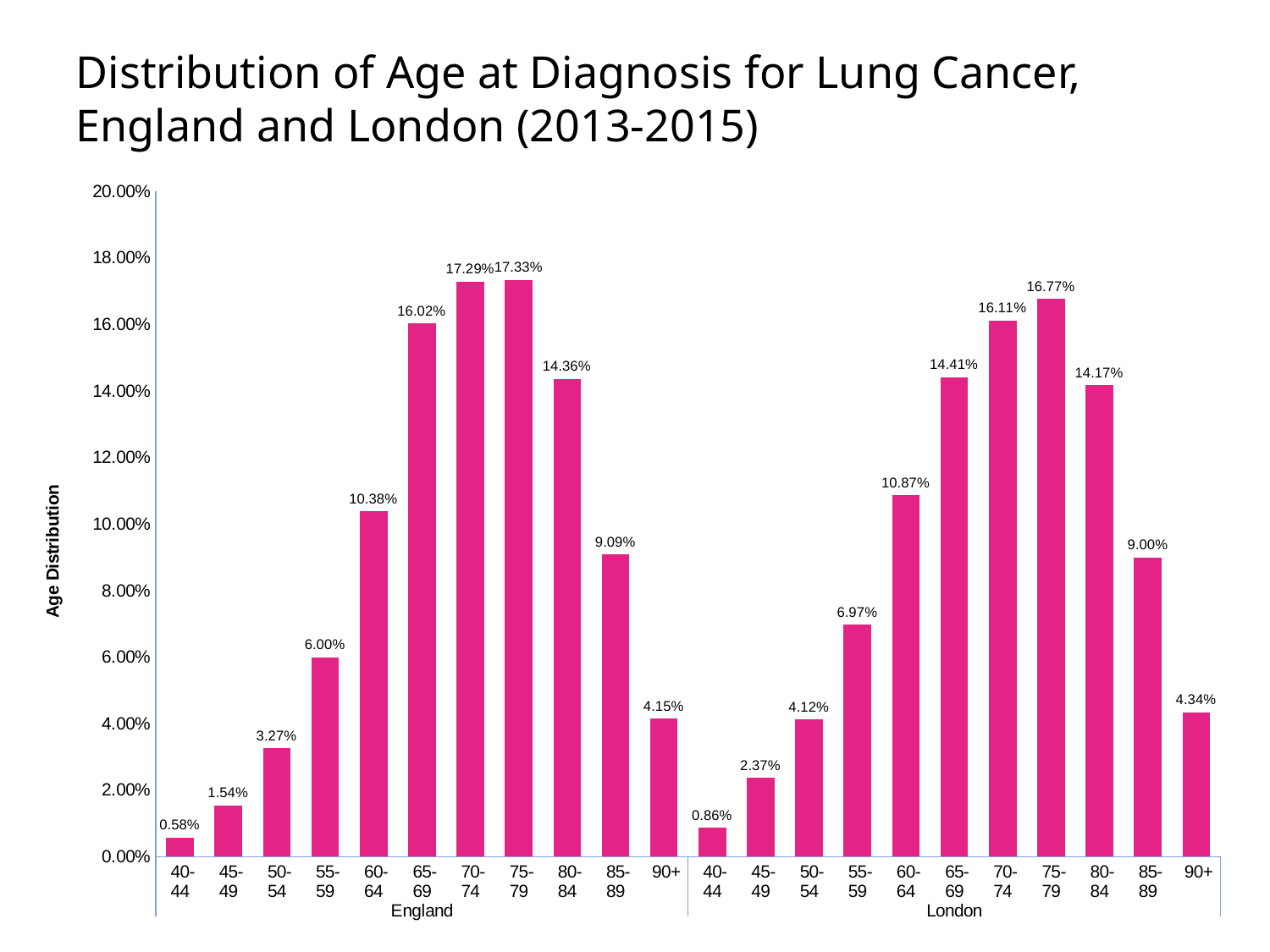
What is the difference between the England and London values for the 65-69 age band? 1.61% What is the value for the 75-79 age band in London? 16.77% What is the value for the 90+ age band in England? 4.15% What is the value for the 60-64 age band in England? 10.38% What kind of chart is shown on the slide? Bar chart What is the difference between the London and England values for the 60-64 age band? 0.49% Which age band has the highest value in the London group? 75-79 Do the values for England rise or fall from the 40-44 age band to the 75-79 age band? Rise Which is larger, the 80-84 value for England or the 80-84 value for London? England How many age bands are shown for each region? 11 Which age band has the lowest value in the England group? 40-44 Is the value for the 55-59 age band in London greater or less than 6.00%? greater